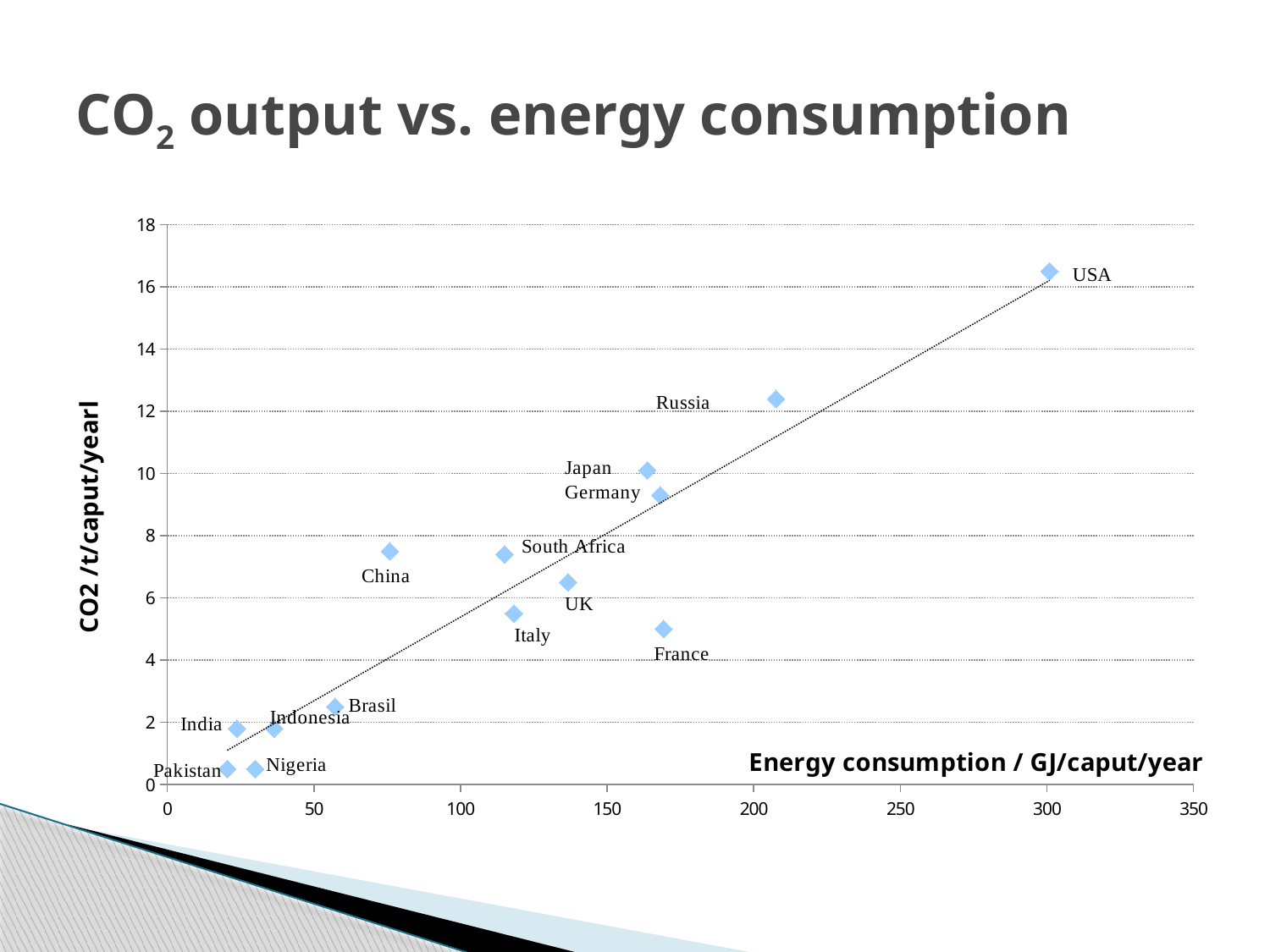
What kind of chart is shown on the slide? scatter chart Which country has the highest CO2 output per caput on the chart? USA Which country has the highest energy consumption per caput on the chart? USA Which has the higher CO2 output per caput, Russia or Japan? Russia Which has the higher CO2 output per caput, UK or France? UK Is the CO2 output value for China greater or less than 8? less What is the label of the x axis? Energy consumption / GJ/caput/year Is the CO2 output value for USA greater or less than 16? greater Which has the higher CO2 output per caput, Japan or Germany? Japan How many labeled country points are plotted on the chart? 14 Do CO2 output values generally rise or fall as energy consumption increases along the x axis? rise Is the energy consumption value for Russia greater or less than 200? greater